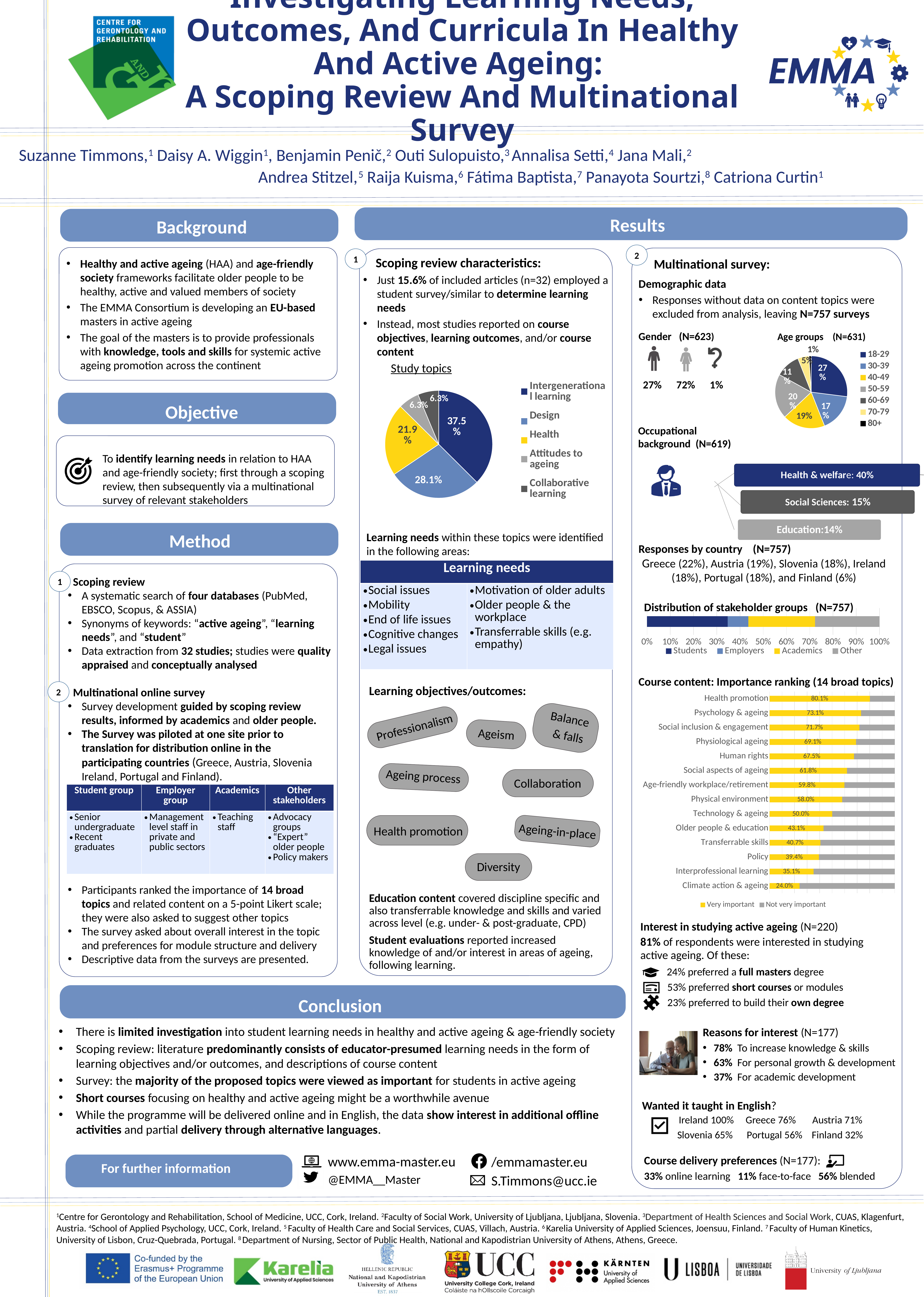
What kind of chart is the 'Course content: Importance ranking (14 broad topics)' chart? Bar chart In the 'Course content: Importance ranking' chart, which topic has the lowest 'Very important' percentage? Climate action & ageing In the 'Study topics' pie chart, what is the difference between the Intergenerational learning share and the Health share? 15.6% In the 'Study topics' pie chart, what percentage is shown for Design? 28.1% How many age groups does the legend of the 'Age groups (N=631)' pie chart list? 7 In the 'Age groups (N=631)' pie chart, what percentage is shown for the 50-59 group? 20% In the 'Study topics' pie chart, which topic has the largest share? Intergenerational learning In the 'Course content: Importance ranking' chart, which is larger: the value for Policy or the value for Transferrable skills? Transferrable skills In the 'Age groups (N=631)' pie chart, which age group has the smallest share? 80+ In the 'Course content: Importance ranking' chart, what percentage is shown for Human rights? 67.5% How many series does the legend of the 'Distribution of stakeholder groups (N=757)' chart list? 4 How many slices does the 'Study topics' pie chart have? 5